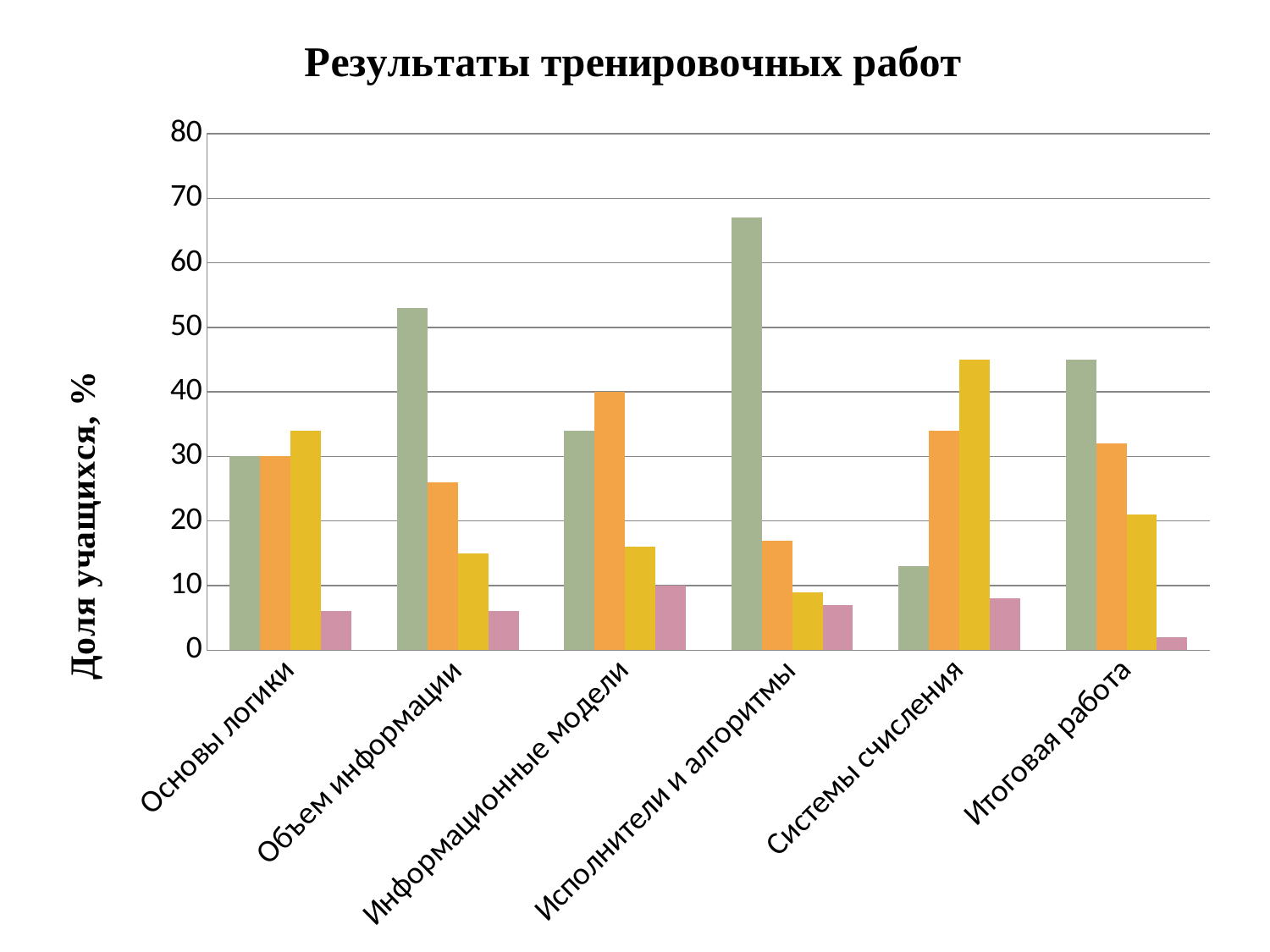
Which category has the tallest green bar? Исполнители и алгоритмы How many categories are shown along the x axis? 6 Is the green bar for Объем информации greater or less than 50? greater What kind of chart is shown on the slide? bar chart Is the orange bar for Исполнители и алгоритмы greater or less than 20? less What value does the orange bar for Информационные модели reach? 40 How many bars are plotted for each category? 4 Which category has the shortest pink bar? Итоговая работа In the Системы счисления category, which is taller: the yellow bar or the green bar? the yellow bar What is the label on the vertical axis of the chart? Доля учащихся, % Which category has the tallest yellow bar? Системы счисления What is the title of the chart? Результаты тренировочных работ